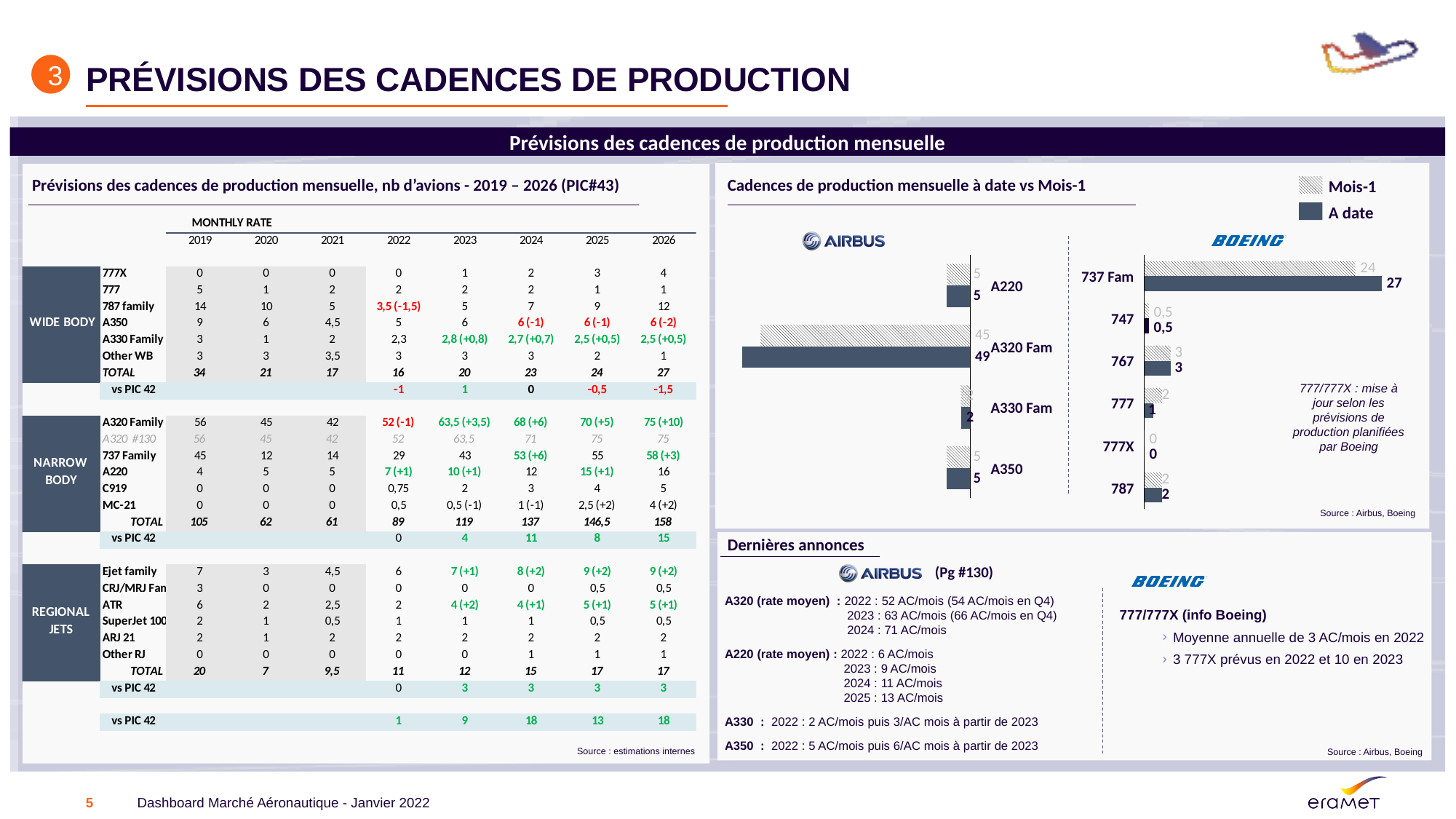
In the chart 'Cadences de production mensuelle à date vs Mois-1', what is the difference between the 'A date' and 'Mois-1' values for the A320 Fam? 4 In the chart 'Cadences de production mensuelle à date vs Mois-1', which Boeing programme has the highest 'A date' value? 737 Fam In the chart 'Cadences de production mensuelle à date vs Mois-1', what is the 'A date' value for the A320 Fam? 49 In the chart 'Cadences de production mensuelle à date vs Mois-1', what is the difference between the 'A date' and 'Mois-1' values for the 737 Fam? 3 In the chart 'Cadences de production mensuelle à date vs Mois-1', what is the 'A date' value for the 747? 0,5 In the chart 'Cadences de production mensuelle à date vs Mois-1', how many series does the legend list? 2 In the chart 'Cadences de production mensuelle à date vs Mois-1', what is the 'Mois-1' value for the 737 Fam? 24 In the chart 'Cadences de production mensuelle à date vs Mois-1', which Airbus programme has the highest 'A date' value? A320 Fam In the chart 'Cadences de production mensuelle à date vs Mois-1', what is the 'A date' value for the 737 Fam? 27 In the chart 'Cadences de production mensuelle à date vs Mois-1', what is the 'Mois-1' value for the A320 Fam? 45 What kind of chart is 'Cadences de production mensuelle à date vs Mois-1'? Bar chart In the chart 'Cadences de production mensuelle à date vs Mois-1', what is the 'A date' value for the 767? 3